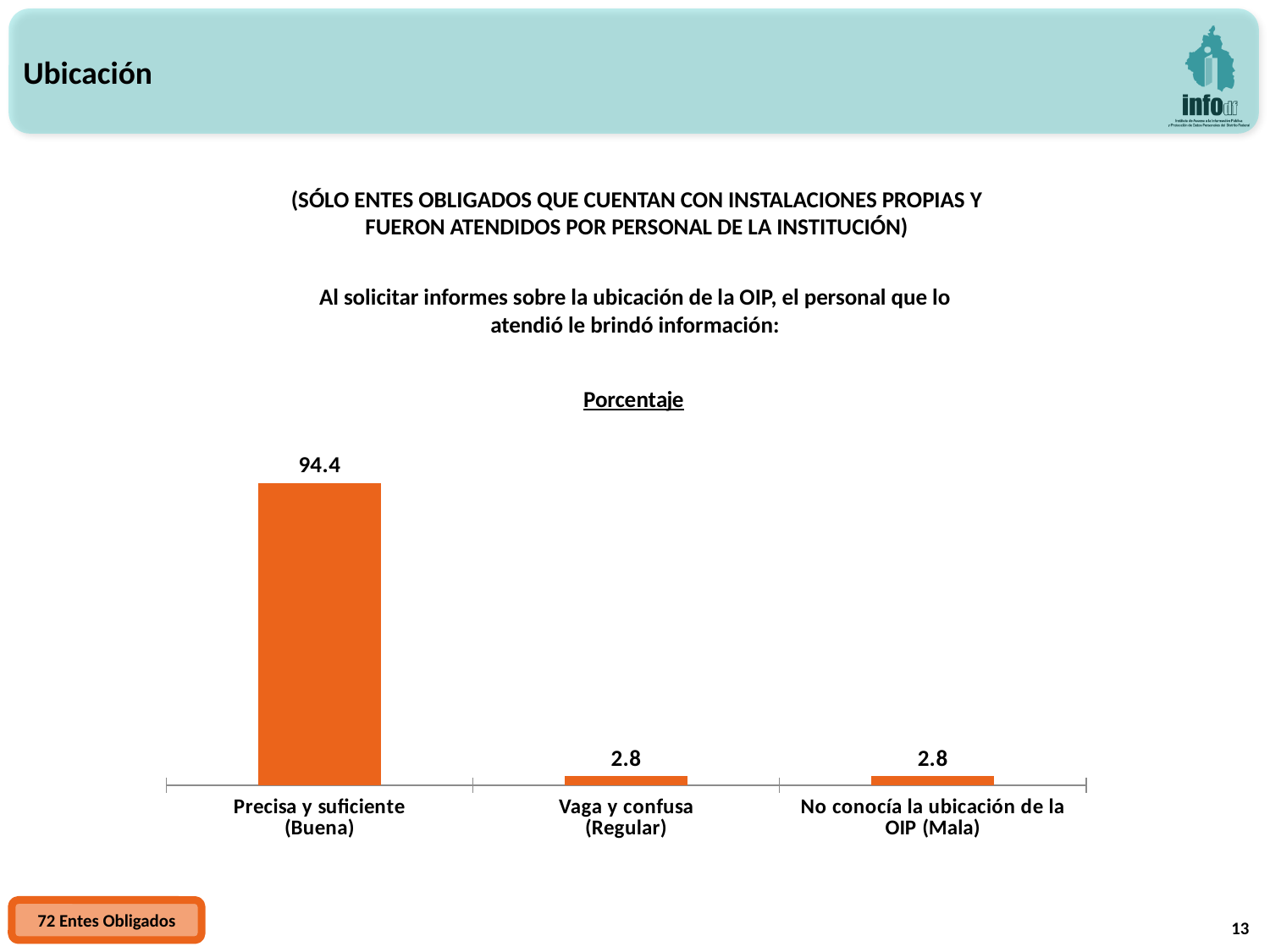
What is the value for "No conocía la ubicación de la OIP (Mala)"? 2.8 What kind of chart is shown on the slide? Bar chart What colour are the bars in the chart? Orange What is the total of the three values shown in the chart? 100 What is the underlined label shown above the chart? Porcentaje Do the values for "Vaga y confusa (Regular)" and "No conocía la ubicación de la OIP (Mala)" have the same value? Yes What is the value for "Vaga y confusa (Regular)"? 2.8 What is the value for "Precisa y suficiente (Buena)"? 94.4 Which is larger, the value for "Precisa y suficiente (Buena)" or the value for "No conocía la ubicación de la OIP (Mala)"? Precisa y suficiente (Buena) What is the difference between the values for "Precisa y suficiente (Buena)" and "Vaga y confusa (Regular)"? 91.6 Which category has the highest value? Precisa y suficiente (Buena) How many categories are shown in the chart? 3